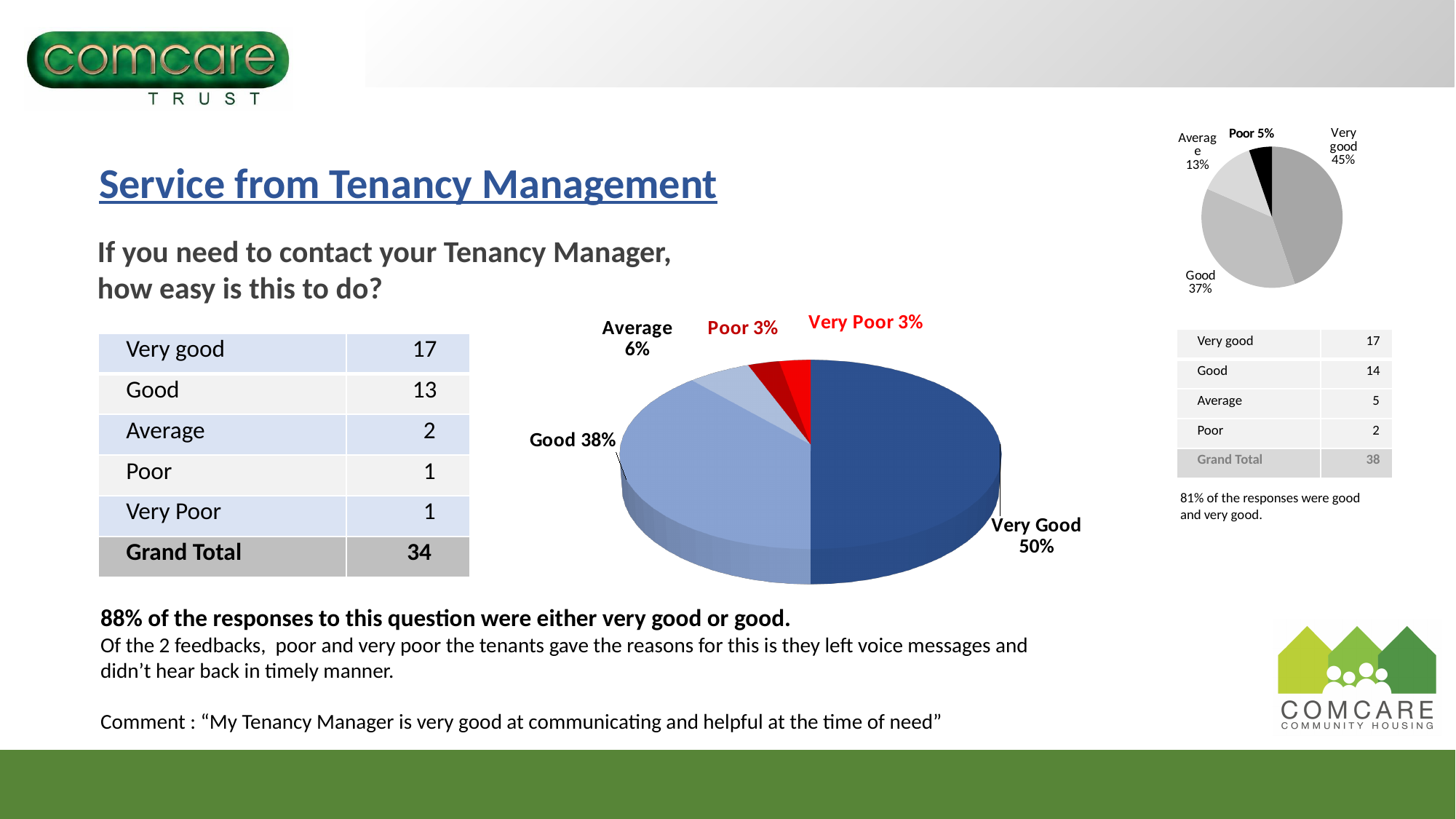
On the large central pie chart, which category has the largest slice? Very Good What kind of chart is the large central chart? Pie chart On the large central pie chart, which is larger, the Good slice or the Average slice? Good On the small grey pie chart at the top right, what share is labelled for Average? 13% On the small grey pie chart at the top right, how many slices are there? 4 On the small grey pie chart at the top right, which category has the smallest slice? Poor On the small grey pie chart at the top right, what share is labelled for Very good? 45% On the large central pie chart, what share is labelled for Average? 6% On the large central pie chart, what is the difference between the Very Good and Good shares? 12% On the large central pie chart, what share is labelled for Very Good? 50% On the large central pie chart, how many slices are there? 5 On the large central pie chart, what share is labelled for Good? 38%